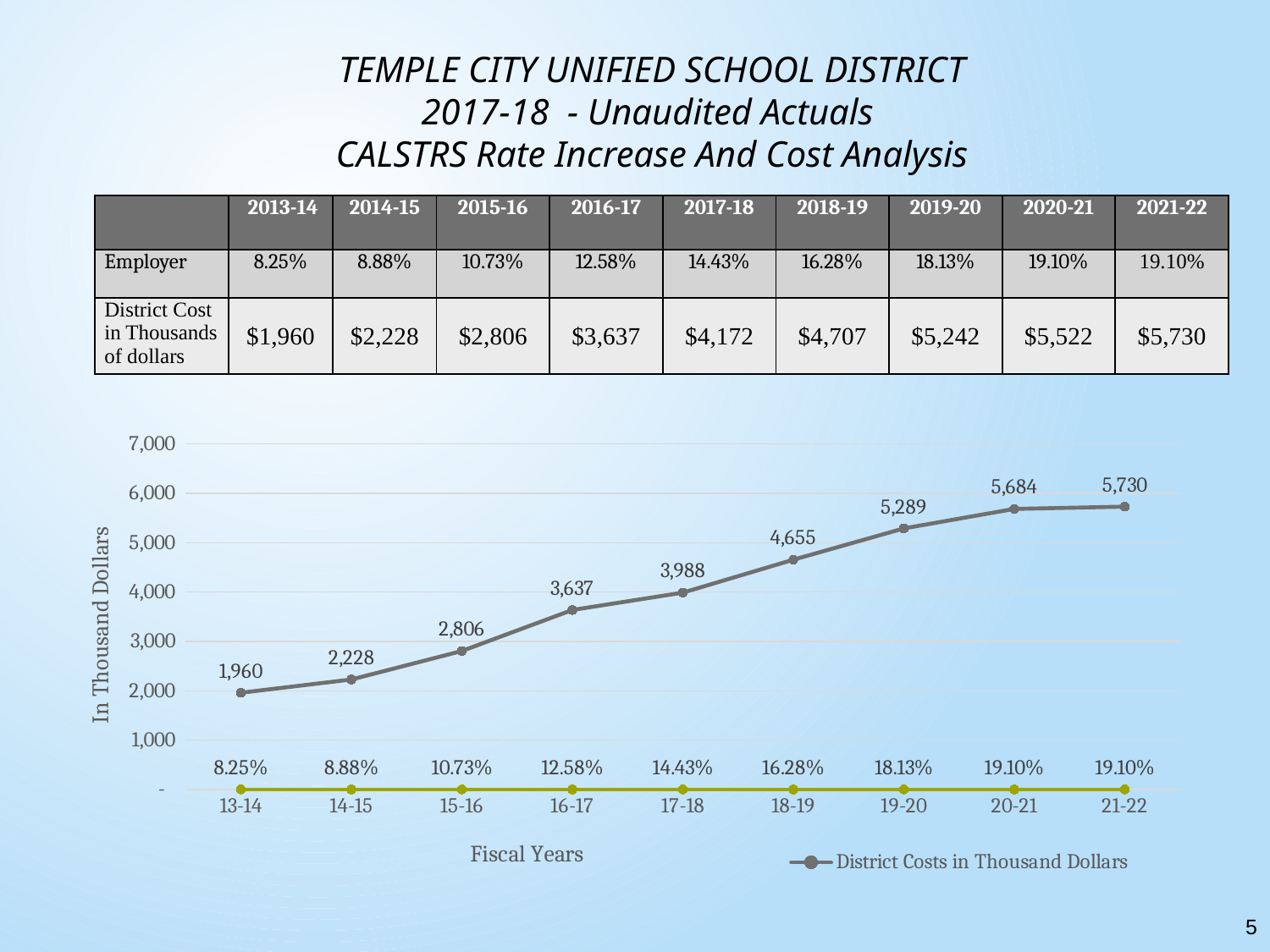
What is the District Costs value plotted for fiscal year 20-21 in the chart? 5,684 What is the difference between the District Costs values for 21-22 and 13-14 in the chart? 3,770 What is the District Costs value plotted for fiscal year 13-14 in the chart? 1,960 Which fiscal year has the highest District Costs value in the chart? 21-22 Which fiscal year has a larger District Costs value in the chart, 15-16 or 18-19? 18-19 Which fiscal year has the lowest District Costs value in the chart? 13-14 What is the difference between the District Costs values for 17-18 and 16-17 in the chart? 351 How many fiscal years are plotted along the x axis of the chart? 9 Do the District Costs values rise or fall from 13-14 to 21-22 in the chart? rise What is the District Costs value plotted for fiscal year 17-18 in the chart? 3,988 What is the label of the y axis of the chart? In Thousand Dollars What kind of chart is shown on the slide? line chart